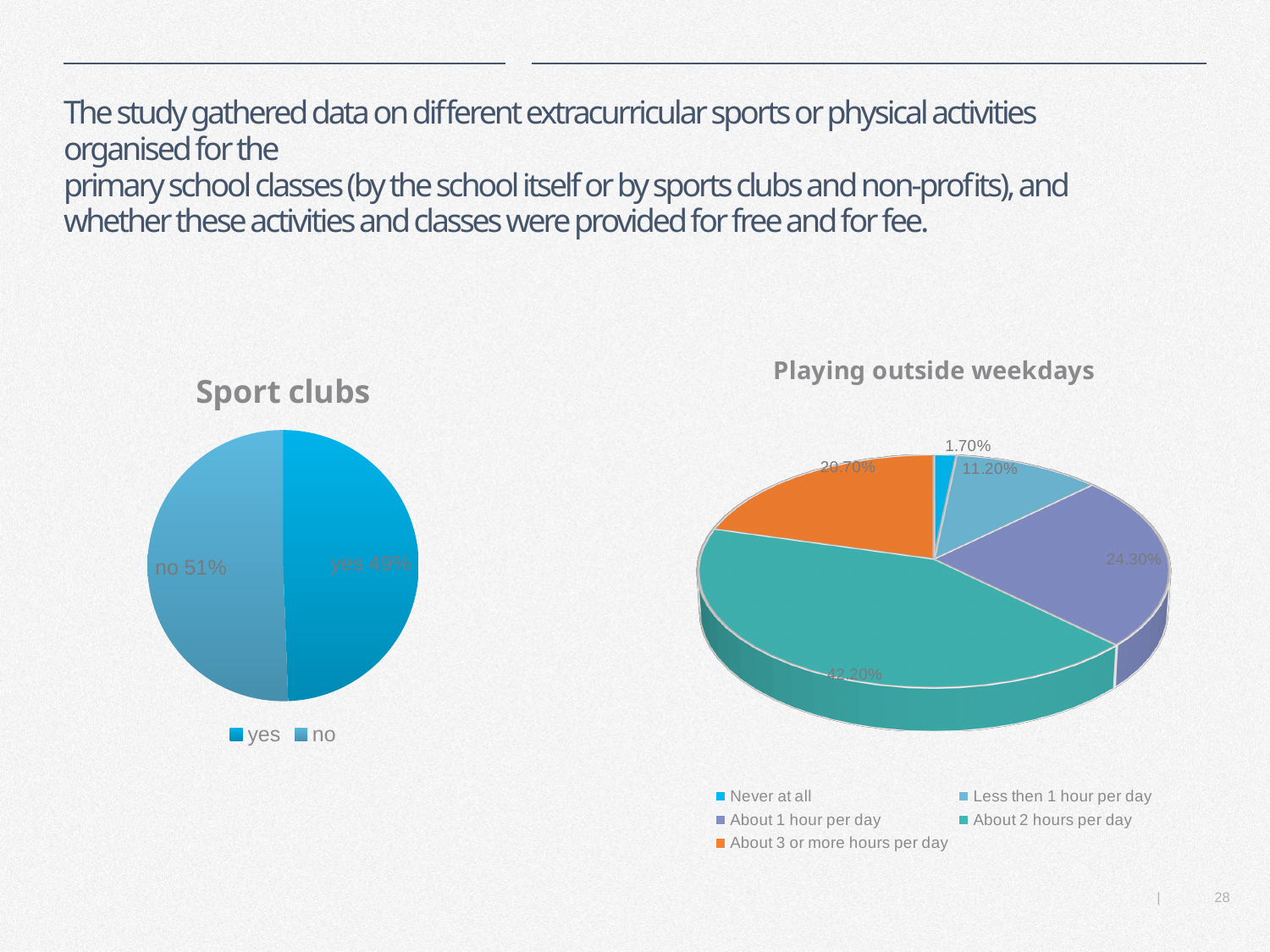
In the 'Playing outside weekdays' chart, what is the share for 'Never at all'? 1.70% In the 'Playing outside weekdays' chart, how many categories does the legend list? 5 What kind of chart is the 'Playing outside weekdays' chart? pie chart In the 'Sport clubs' chart, what percentage answered no? 51% In the 'Playing outside weekdays' chart, what is the share for 'About 3 or more hours per day'? 20.70% In the 'Playing outside weekdays' chart, which category has the largest share? About 2 hours per day In the 'Playing outside weekdays' chart, what is the difference between the shares for 'About 1 hour per day' and 'Less then 1 hour per day'? 13.10% In the 'Playing outside weekdays' chart, what is the share for 'About 2 hours per day'? 42.20% In the 'Sport clubs' chart, how many categories does the legend list? 2 In the 'Sport clubs' chart, which category has the larger share, yes or no? no In the 'Playing outside weekdays' chart, which category has the smallest share? Never at all In the 'Sport clubs' chart, what percentage answered yes? 49%